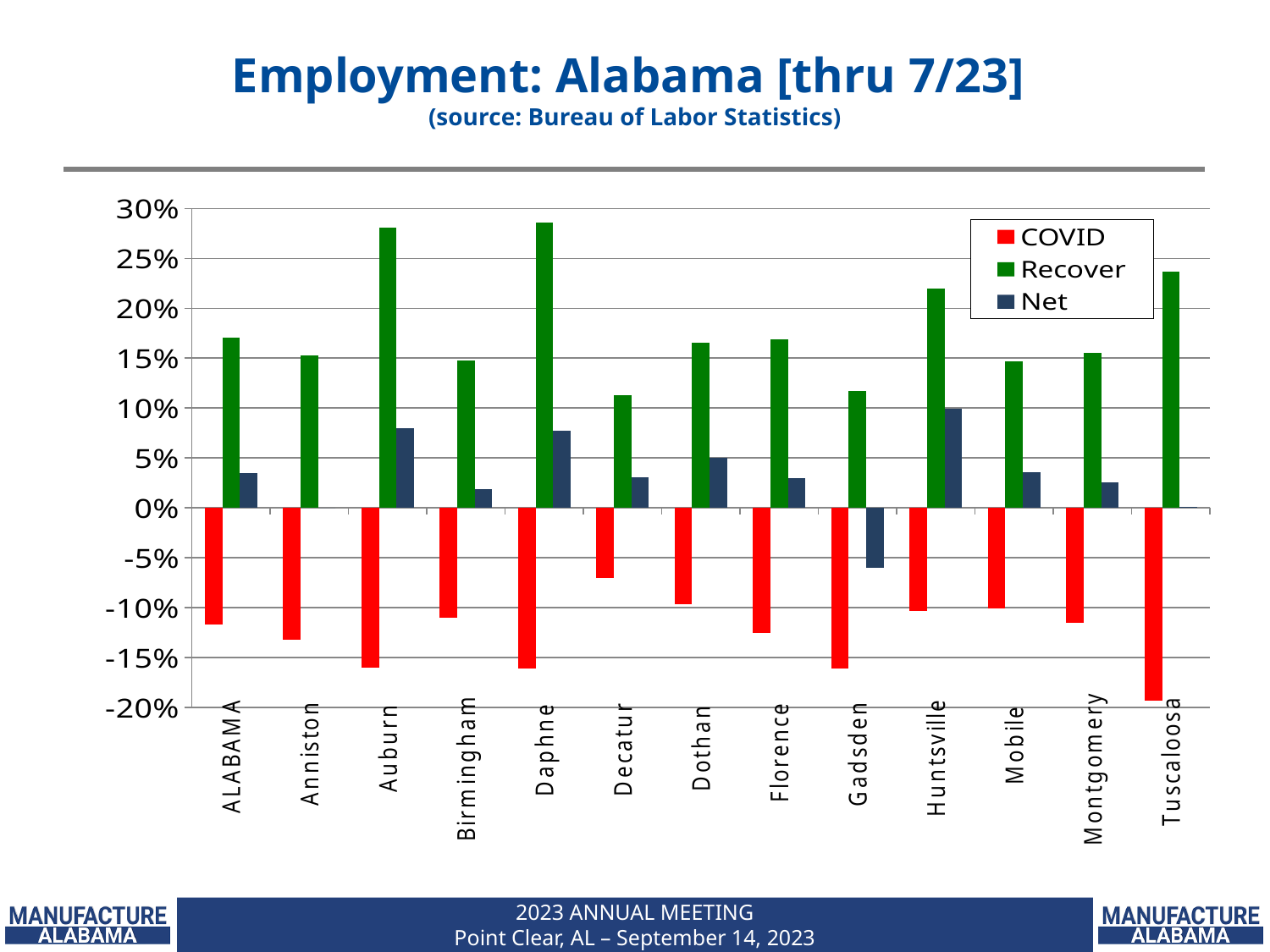
Is the Recover value for Auburn greater or less than 25%? greater Which category has the lowest COVID value? Tuscaloosa Is the COVID value for Tuscaloosa greater or less than -15%? less Which is larger, the Net value for Huntsville or the Net value for Auburn? Huntsville How many series does the legend list? 3 Which colour represents the Recover series in the legend? green Which category has the highest Net value? Huntsville Is the Net value for Gadsden greater or less than 0%? less How many categories are shown along the x axis? 13 What kind of chart is shown on the slide? bar chart Which category has the lowest Net value? Gadsden